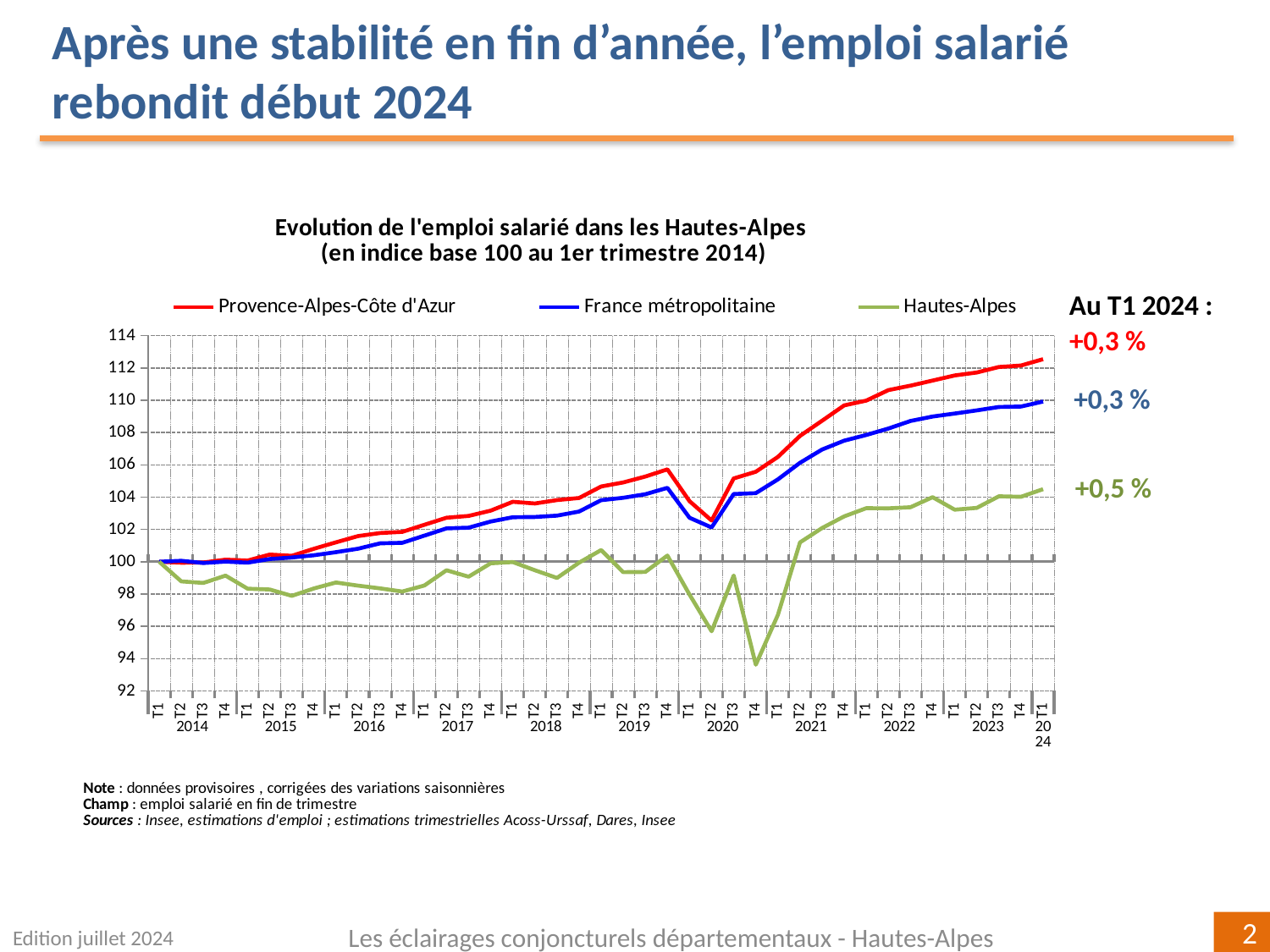
Which series has the highest index value at T1 2024? Provence-Alpes-Côte d'Azur What kind of chart is shown on the slide? line chart What quarterly change is annotated for Provence-Alpes-Côte d'Azur at T1 2024? +0,3 % Is the France métropolitaine index at T1 2024 greater or less than 108? greater Which series has the lowest index value at T1 2024? Hautes-Alpes What quarterly change is annotated for Hautes-Alpes at T1 2024? +0,5 % Does the Provence-Alpes-Côte d'Azur index rise or fall between T1 2021 and T1 2024? rise Is the Hautes-Alpes index at T4 2020 greater or less than 96? less What is the base period of the index used in the chart, according to its title? 1er trimestre 2014 How many series does the legend list? 3 Is the Provence-Alpes-Côte d'Azur index at T1 2024 greater or less than 112? greater Which series is shown in green in the legend? Hautes-Alpes